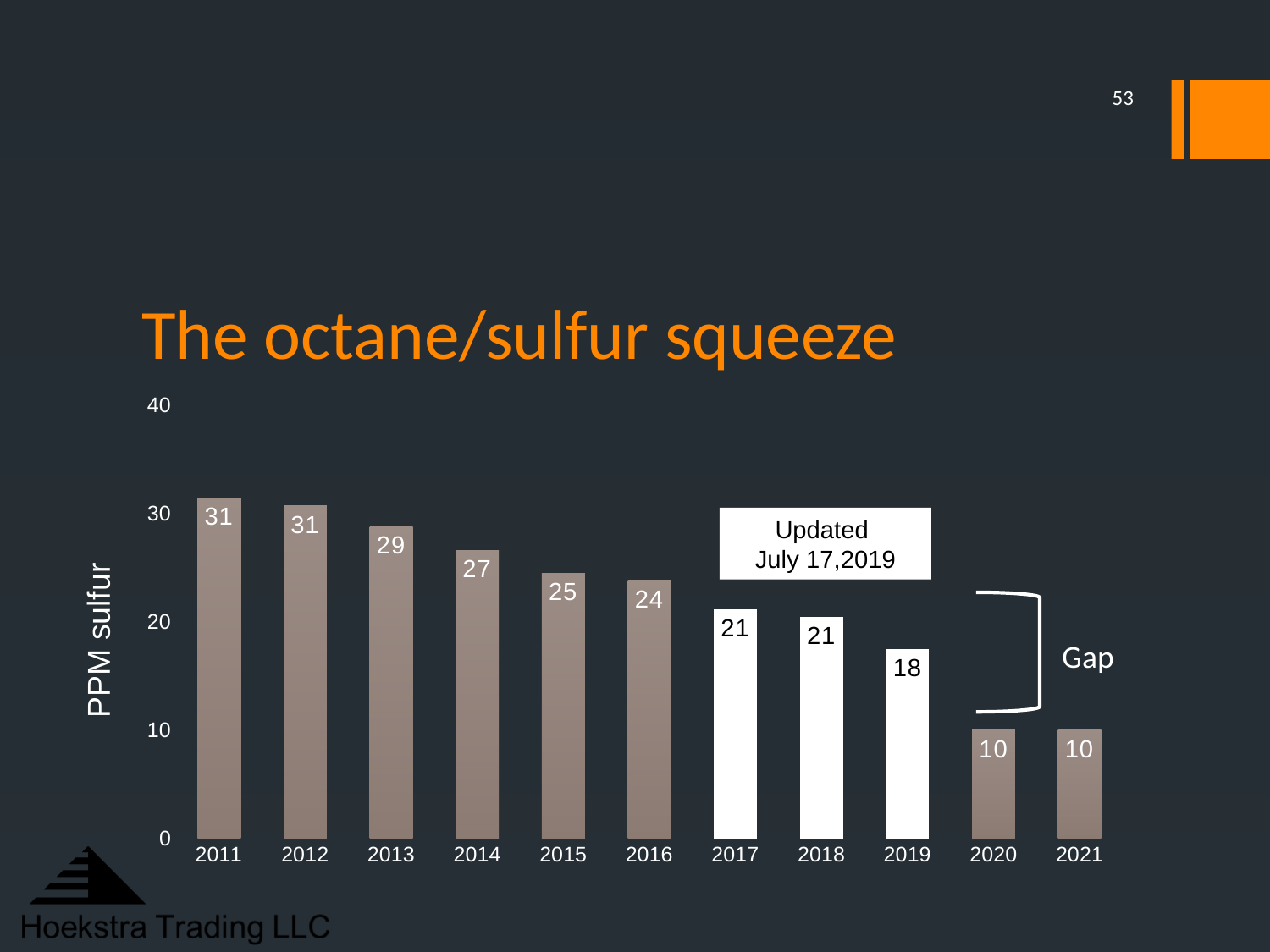
How many years are shown on the x axis? 11 What is the title of the slide containing the chart? The octane/sulfur squeeze What is the difference in PPM sulfur between 2016 and 2017? 3 What is the PPM sulfur value for 2011? 31 Which year has the lowest PPM sulfur value? 2020 and 2021 Which year has a higher PPM sulfur value, 2013 or 2015? 2013 What is the PPM sulfur value for 2021? 10 What is the PPM sulfur value for 2019? 18 Do the PPM sulfur values rise or fall from 2011 to 2021? Fall What is the difference in PPM sulfur between 2019 and 2020? 8 What is the PPM sulfur value for 2014? 27 What kind of chart is shown on the slide? Bar chart